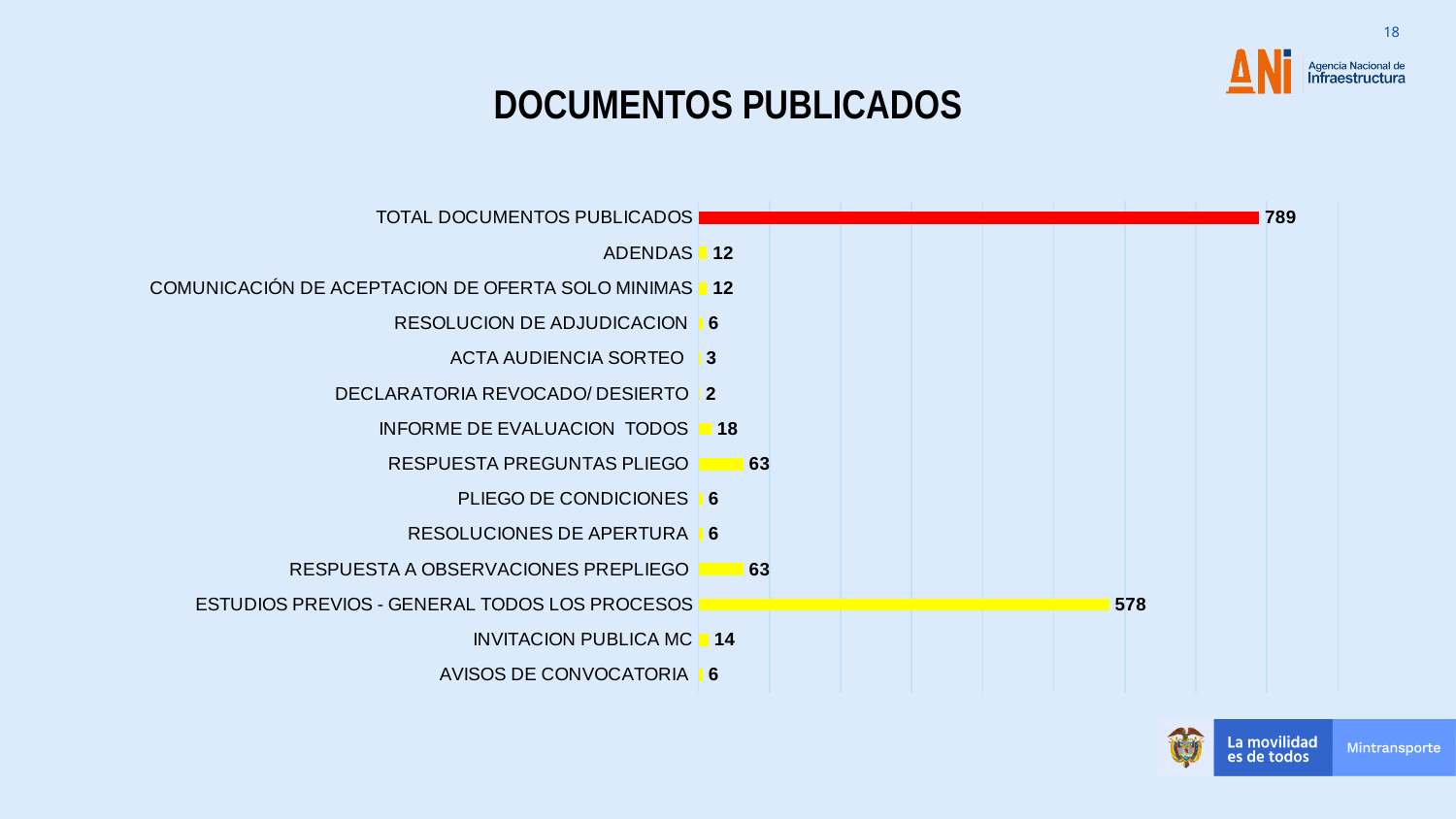
Which category has the highest value? TOTAL DOCUMENTOS PUBLICADOS What is the value for INVITACION PUBLICA MC? 14 Which is larger, INVITACION PUBLICA MC or ADENDAS? INVITACION PUBLICA MC Which category has the lowest value? DECLARATORIA REVOCADO/ DESIERTO What is the value for TOTAL DOCUMENTOS PUBLICADOS? 789 What is the value for ESTUDIOS PREVIOS - GENERAL TODOS LOS PROCESOS? 578 What kind of chart is shown on the slide? Bar chart What is the difference between TOTAL DOCUMENTOS PUBLICADOS and ESTUDIOS PREVIOS - GENERAL TODOS LOS PROCESOS? 211 What is the title of the chart? DOCUMENTOS PUBLICADOS How many categories are shown in the chart? 14 What is the difference between RESPUESTA PREGUNTAS PLIEGO and INFORME DE EVALUACION TODOS? 45 What is the value for INFORME DE EVALUACION TODOS? 18